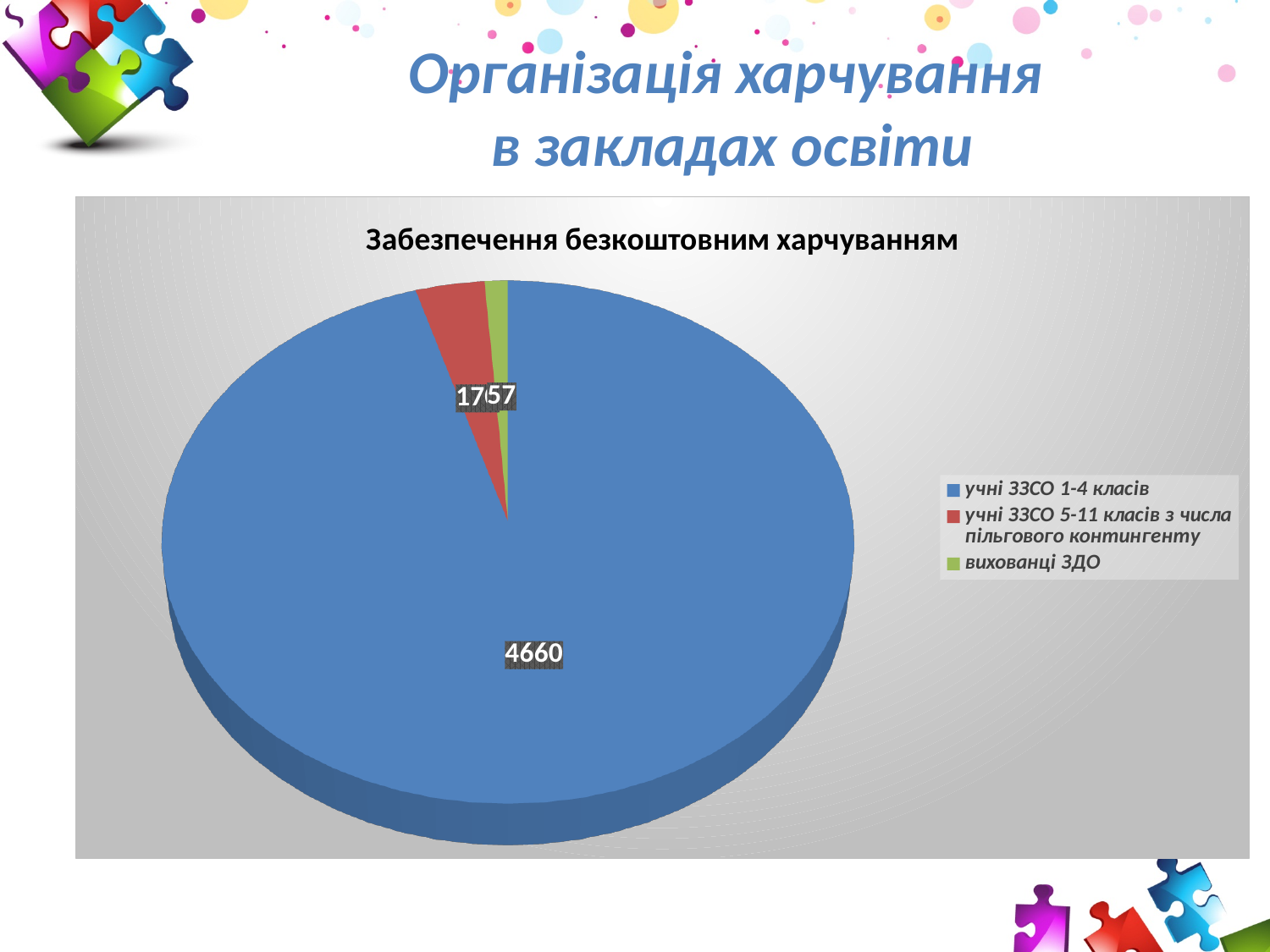
What kind of chart is shown on the slide? pie chart How many entries does the legend list? 3 Which category has the smallest slice of the pie? вихованці ЗДО Which is larger: the slice for учні ЗЗСО 5-11 класів з числа пільгового контингенту or the slice for вихованці ЗДО? учні ЗЗСО 5-11 класів з числа пільгового контингенту What is the value for учні ЗЗСО 1-4 класів? 4660 How many slices does the pie chart have? 3 What is the title of the chart? Забезпечення безкоштовним харчуванням What colour is the slice for вихованці ЗДО? green Which category has the largest slice of the pie? учні ЗЗСО 1-4 класів Which is larger: the slice for учні ЗЗСО 1-4 класів or the slice for учні ЗЗСО 5-11 класів з числа пільгового контингенту? учні ЗЗСО 1-4 класів